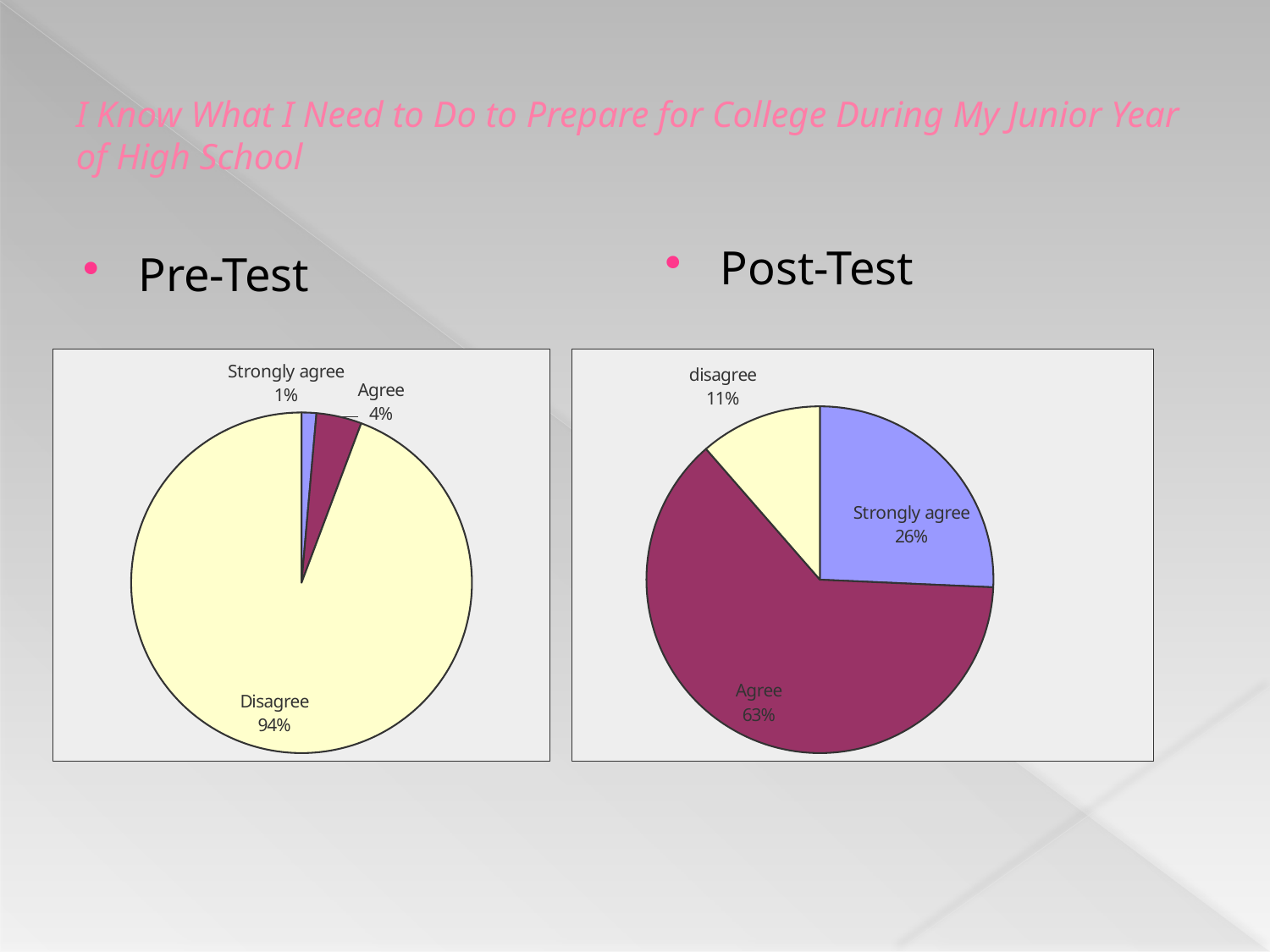
In the Pre-Test pie chart, which category has the largest slice? Disagree How many slices does the Pre-Test pie chart have? 3 In the Pre-Test pie chart, what percentage is shown for Disagree? 94% In the Post-Test pie chart, which category has the smallest slice? disagree What type of chart is used for the Post-Test data? Pie chart In the Post-Test pie chart, what percentage is shown for Strongly agree? 26% In the Post-Test pie chart, what percentage is shown for Agree? 63% Which is larger in the Post-Test pie chart: Strongly agree or disagree? Strongly agree In the Pre-Test pie chart, what percentage is shown for Agree? 4% In the Pre-Test pie chart, what percentage is shown for Strongly agree? 1% In the Post-Test pie chart, what percentage is shown for disagree? 11% In the Post-Test pie chart, what is the difference in percentage points between Agree and Strongly agree? 37